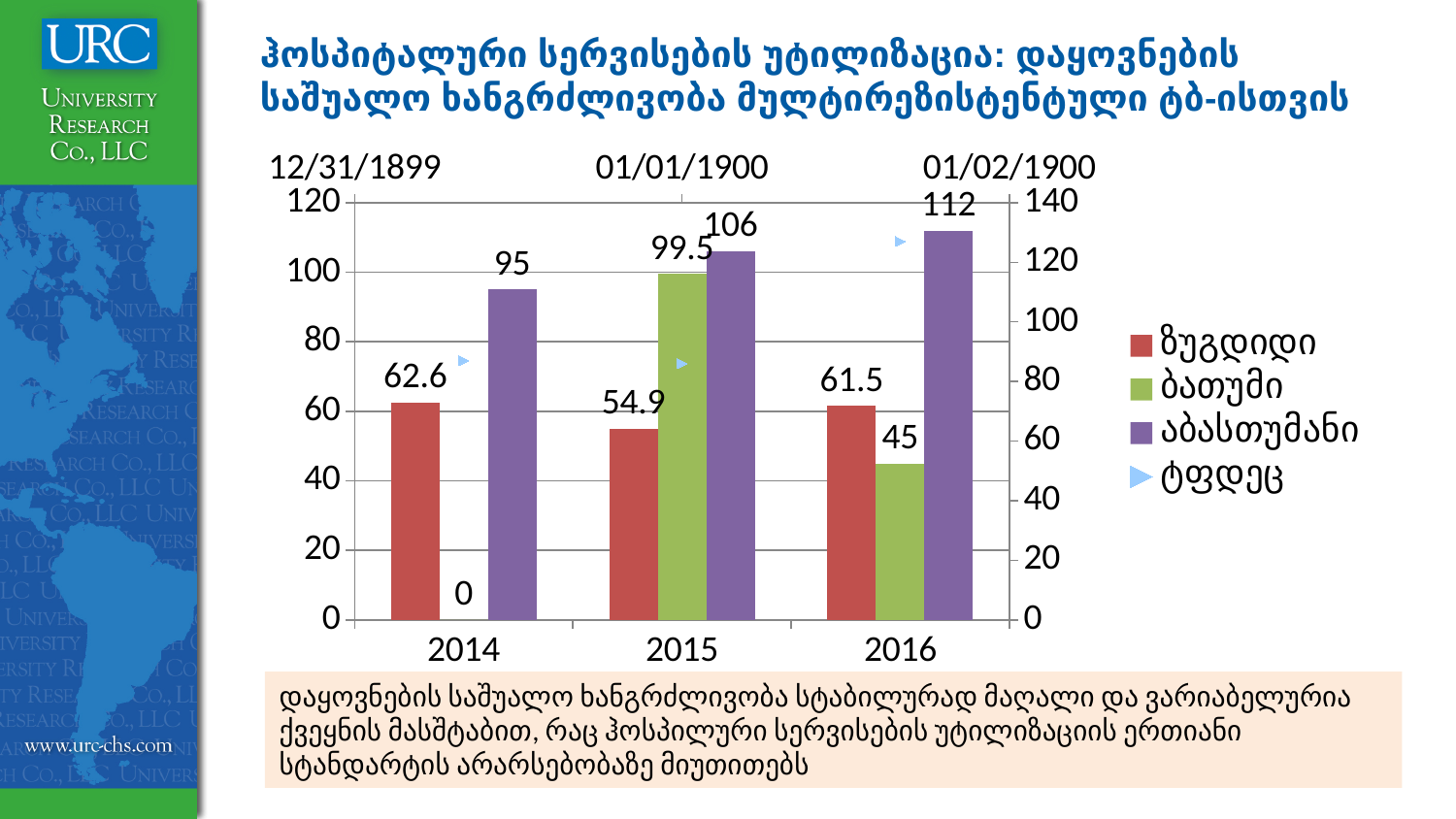
In which year is the value for ზუგდიდი lowest? 2015 Do the values for აბასთუმანი rise or fall from 2014 to 2016? rise What is the value for აბასთუმანი in 2016? 112 What is the value for ზუგდიდი in 2014? 62.6 How many series does the legend list? 4 What is the value for ბათუმი in 2015? 99.5 What kind of chart is shown on the slide? bar chart In which year is the value for აბასთუმანი highest? 2016 Which is larger in 2016, the value for ზუგდიდი or the value for ბათუმი? ზუგდიდი What is the value for ბათუმი in 2014? 0 What is the difference between the აბასთუმანი value and the ზუგდიდი value in 2015? 51.1 How many years are shown on the x axis? 3